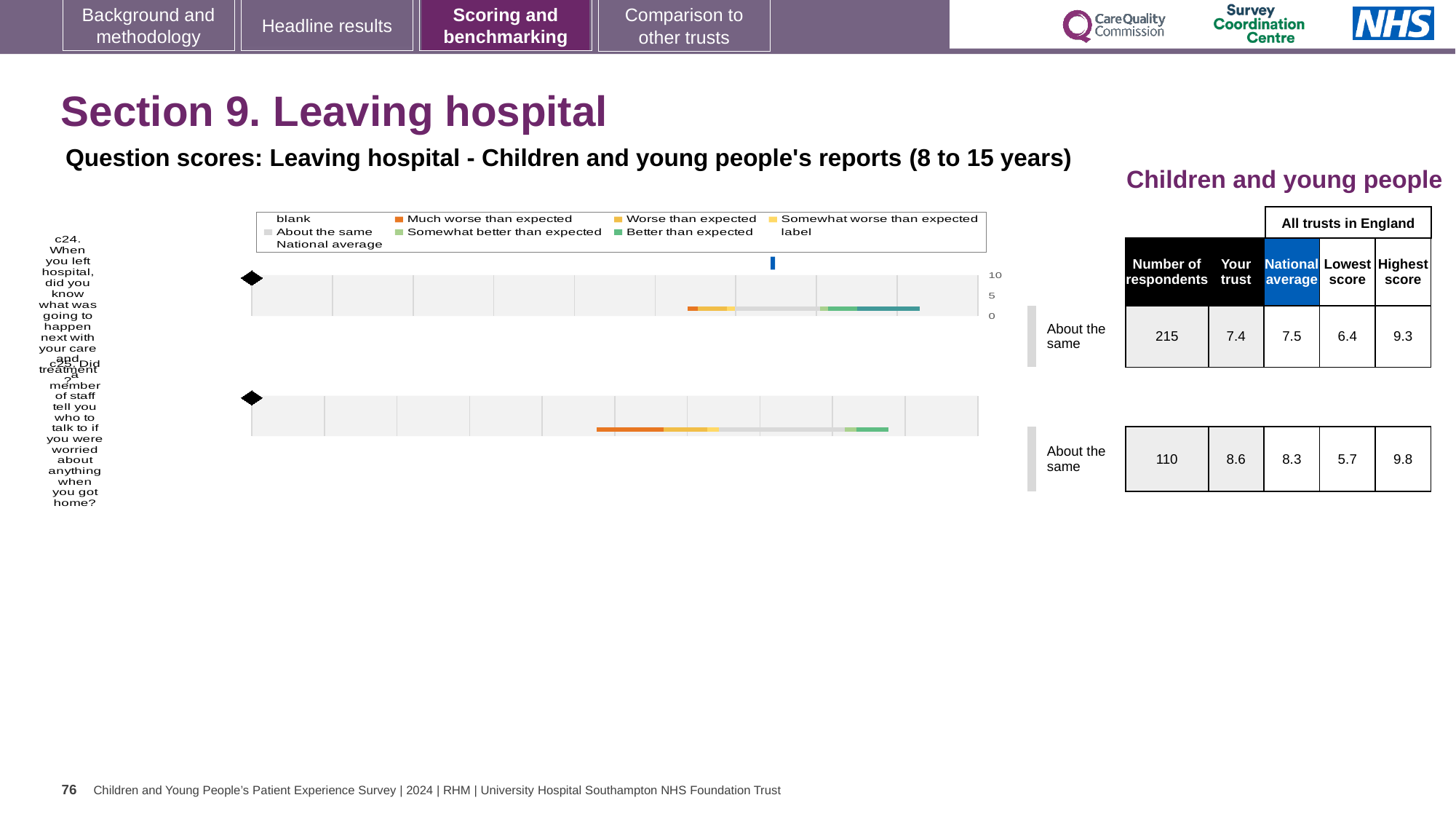
Which legend entry is shown in orange? Much worse than expected What kind of chart is used to show the question scores for c24 and c25? bar chart What is the national average score for c25? 8.3 What is the difference between the highest score and the lowest score for c24? 2.9 What is the 'Your trust' score for c25 (Did a member of staff tell you who to talk to if you were worried about anything when you got home?)? 8.6 What benchmark category label is shown next to the c24 chart? About the same How many questions (c24 and c25) are plotted as separate bars on the slide? 2 What is the highest tick value shown on the chart's axis? 10 What is the 'Your trust' score for c24 (When you left hospital, did you know what was going to happen next with your care and treatment?)? 7.4 How many entries does the chart legend list? 9 What benchmark category label is shown next to the c25 chart? About the same Which question has the higher 'Your trust' score, c24 or c25? c25